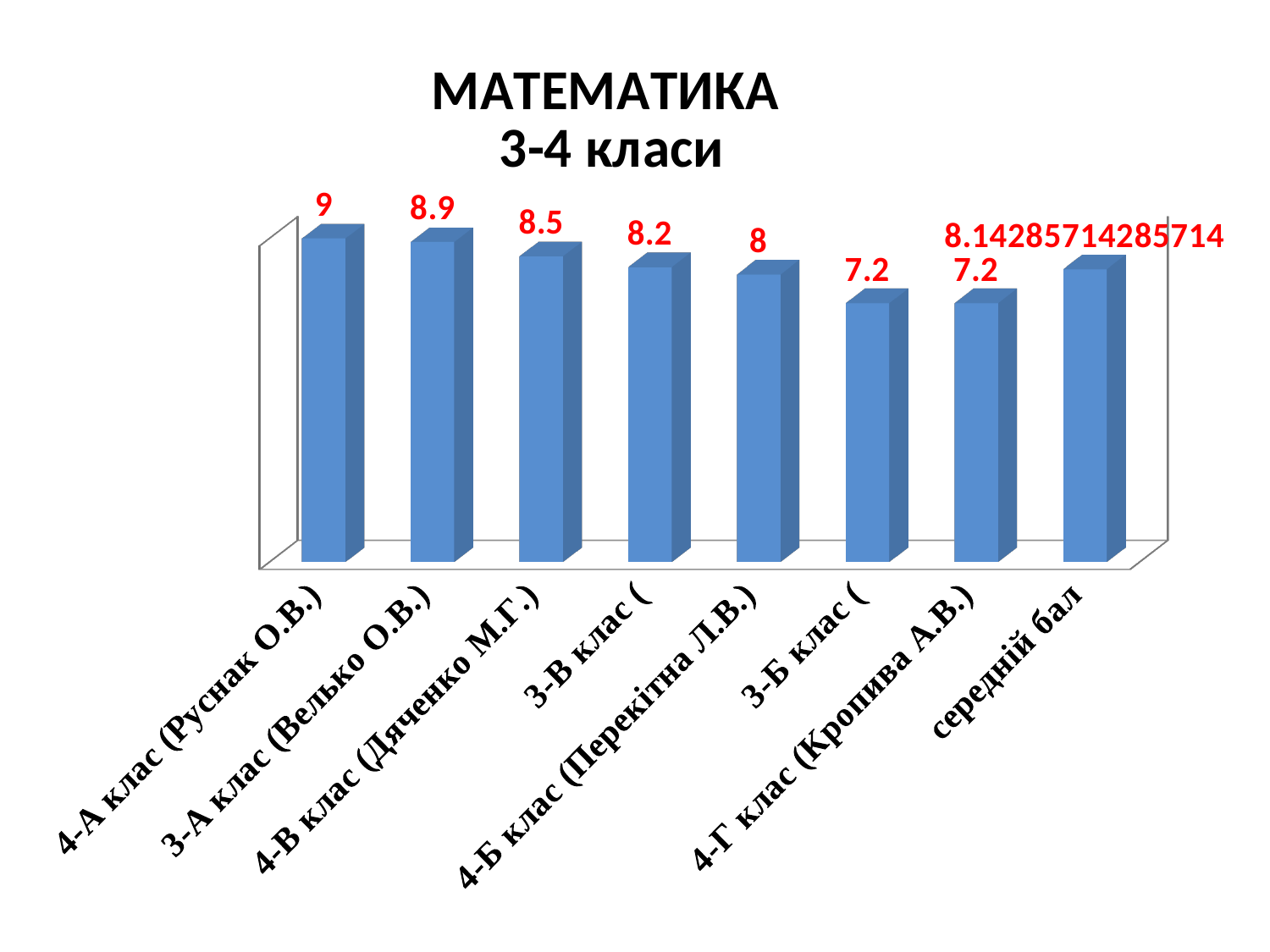
What is the difference between the values for 4-А клас (Руснак О.В.) and 4-Г клас (Кропива А.В.)? 1.8 What kind of chart is shown on the slide? bar chart What is the value shown for середній бал? 8.14285714285714 What is the value for 4-А клас (Руснак О.В.)? 9 What is the title of the chart? МАТЕМАТИКА 3-4 класи How many bars are shown on the chart? 8 What is the value for 4-В клас (Дяченко М.Г.)? 8.5 What is the lowest value shown on the chart? 7.2 What is the value for 4-Б клас (Перекітна Л.В.)? 8 What is the value for 3-А клас (Велько О.В.)? 8.9 Which category has the highest value? 4-А клас (Руснак О.В.) Which is larger, the value for 3-А клас (Велько О.В.) or the value for 4-В клас (Дяченко М.Г.)? 3-А клас (Велько О.В.)